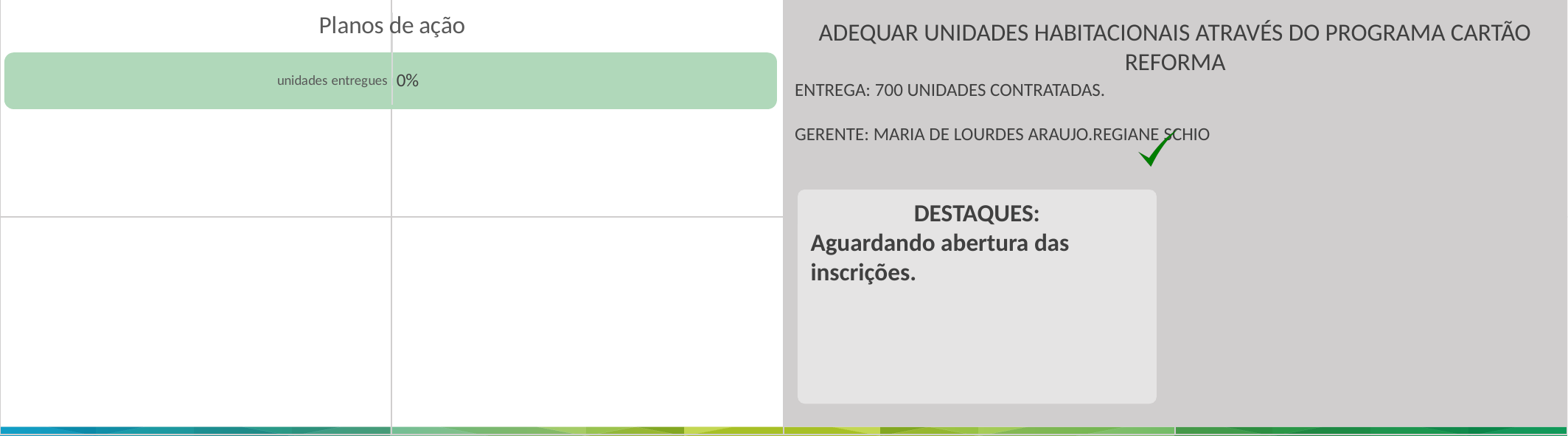
What is the title of the chart on the left side of the slide? Planos de ação What is the value shown for "unidades entregues" in the "Planos de ação" chart? 0% How many categories are plotted in the "Planos de ação" chart? 1 What is the label of the only category in the "Planos de ação" chart? unidades entregues What kind of chart is the "Planos de ação" chart? bar chart